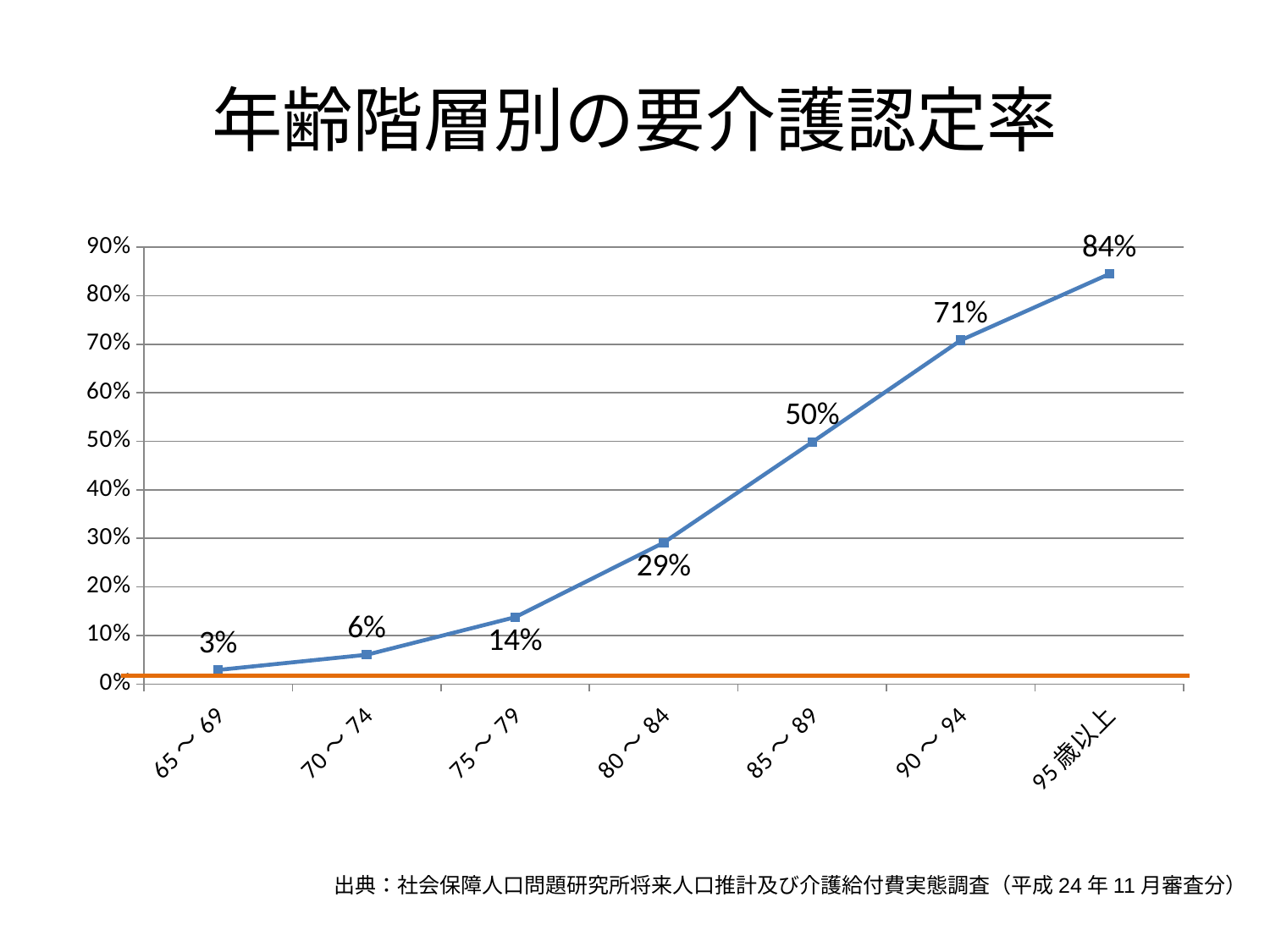
How many age groups are plotted on the x axis? 7 Which is larger, the value for 75～79 or the value for 70～74? 75～79 Do the values rise or fall as age increases along the x axis? Rise Which age group has the lowest value? 65～69 What is the difference between the values for 85～89 and 80～84? 21% What is the value for the 80～84 age group? 29% Which age group has the highest value? 95歳以上 What is the value for the 90～94 age group? 71% What is the difference between the values for 95歳以上 and 90～94? 13% What is the value for the 65～69 age group? 3% What kind of chart is shown on the slide? Line chart What is the title of the chart? 年齢階層別の要介護認定率